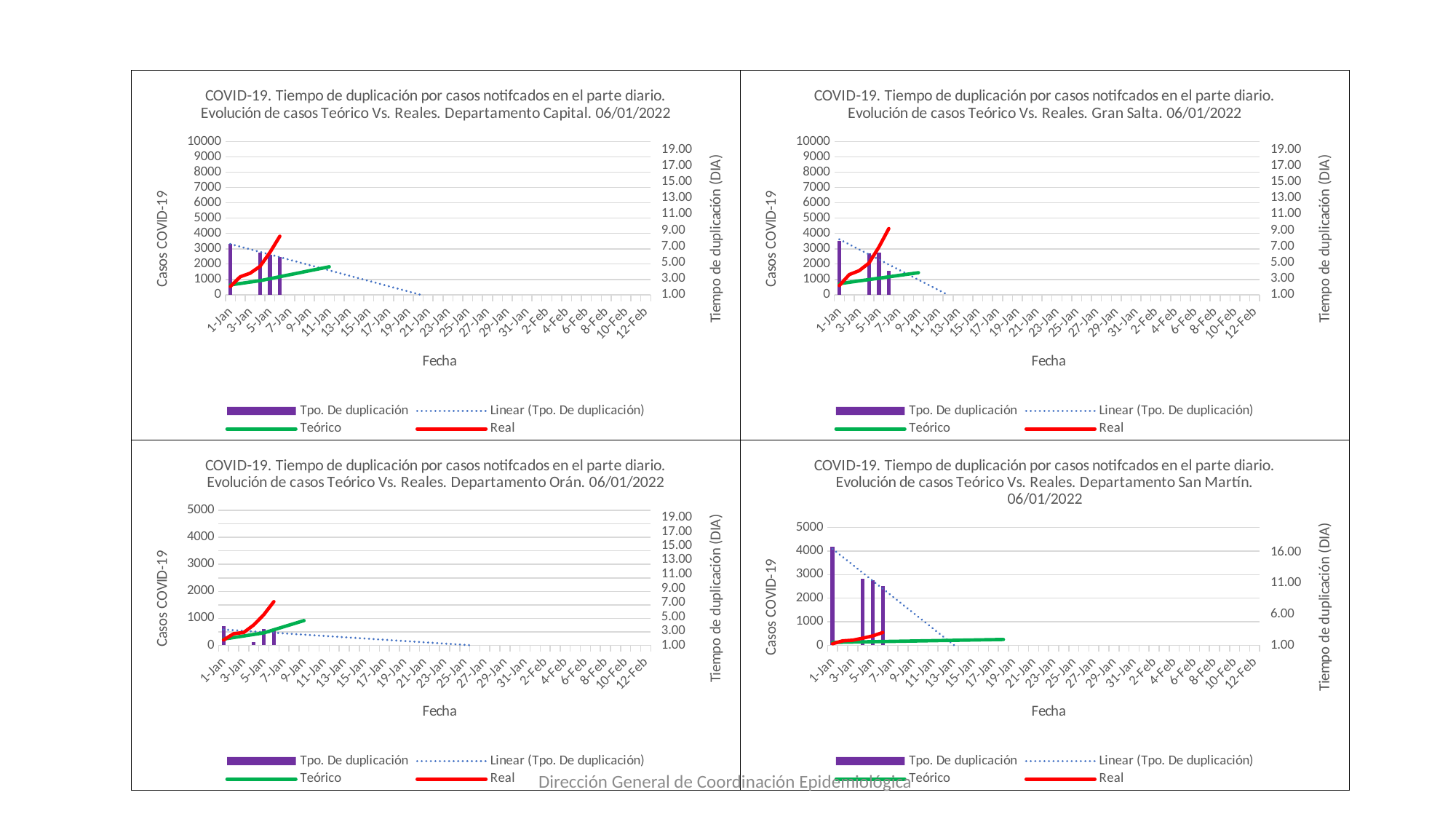
What is the title of the left vertical axis in the Gran Salta chart (top right)? Casos COVID-19 In the Departamento Capital chart (top left), does the Real line rise or fall from 1-Jan to 7-Jan? rise In the Departamento San Martín chart (bottom right), is the Tpo. De duplicación bar on 1-Jan greater or less than 11.00 days on the right axis? greater What is the maximum value shown on the left vertical axis of the Departamento Orán chart (bottom left)? 5000 How many series does the legend list for the Departamento Capital chart (top left)? 4 In the Departamento Orán chart (bottom left), is the highest Real value greater or less than 1000 cases? greater In the Gran Salta chart (top right), what are the four legend entries? Tpo. De duplicación, Linear (Tpo. De duplicación), Teórico, Real In the Departamento Orán chart (bottom left), does the dotted Linear (Tpo. De duplicación) line rise or fall along the x axis? fall In the Departamento San Martín chart (bottom right), is the highest Real value greater or less than 1000 cases? less